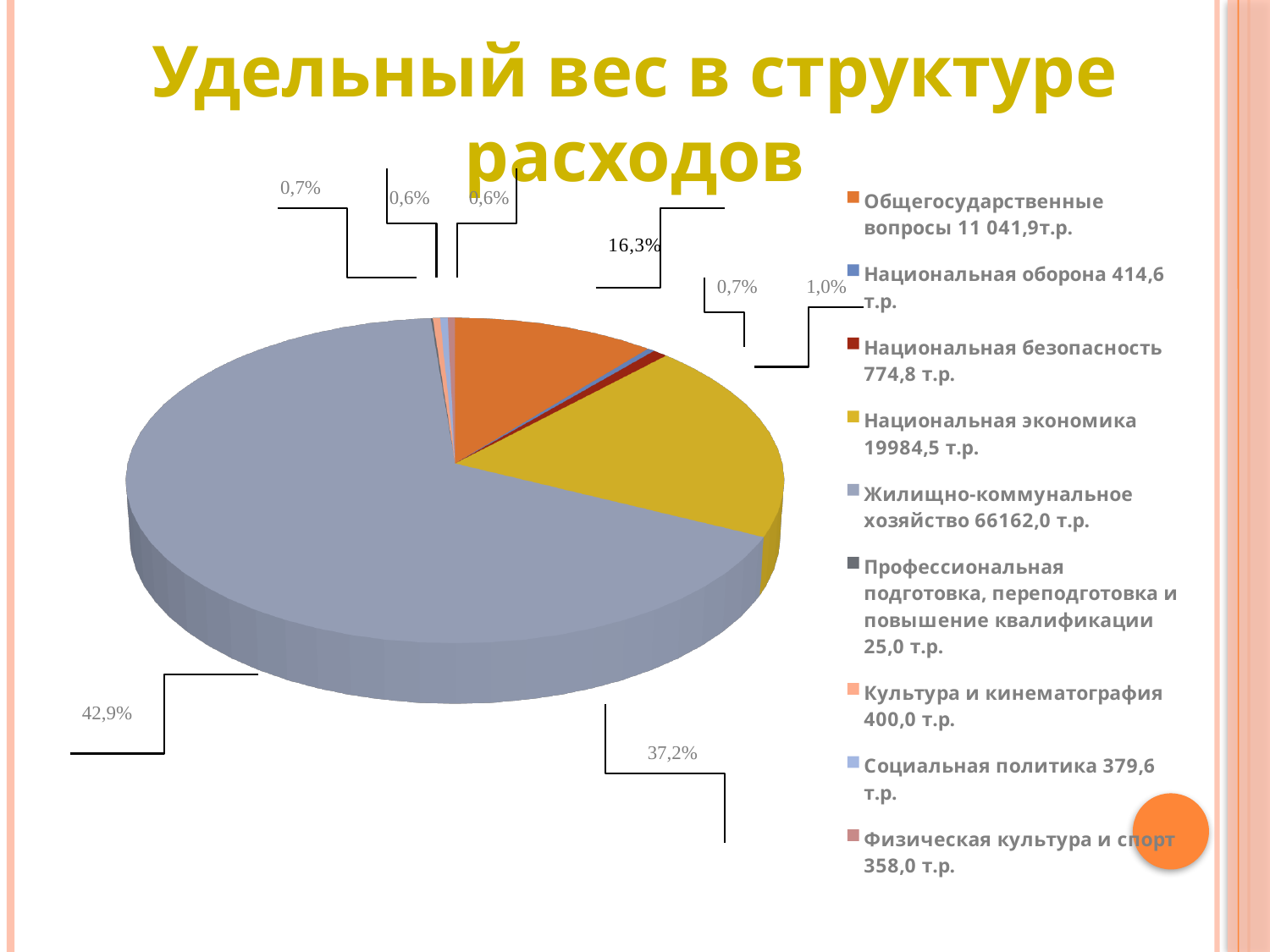
What value is given in the legend for Физическая культура и спорт? 358,0 т.р. What kind of chart is shown on the slide? Pie chart What value is given in the legend for Национальная экономика? 19984,5 т.р. Which category has the largest slice of the pie? Жилищно-коммунальное хозяйство What value is given in the legend for Жилищно-коммунальное хозяйство? 66162,0 т.р. What colour is the slice for Национальная экономика? Yellow What is the difference between the legend values for Национальная экономика and Общегосударственные вопросы? 8942,6 т.р. Which is larger: Национальная экономика or Общегосударственные вопросы? Национальная экономика How many categories does the legend of the pie chart list? 9 Which category has the smallest value according to the legend? Профессиональная подготовка, переподготовка и повышение квалификации What is the title of the chart? Удельный вес в структуре расходов What value is given in the legend for Национальная оборона? 414,6 т.р.